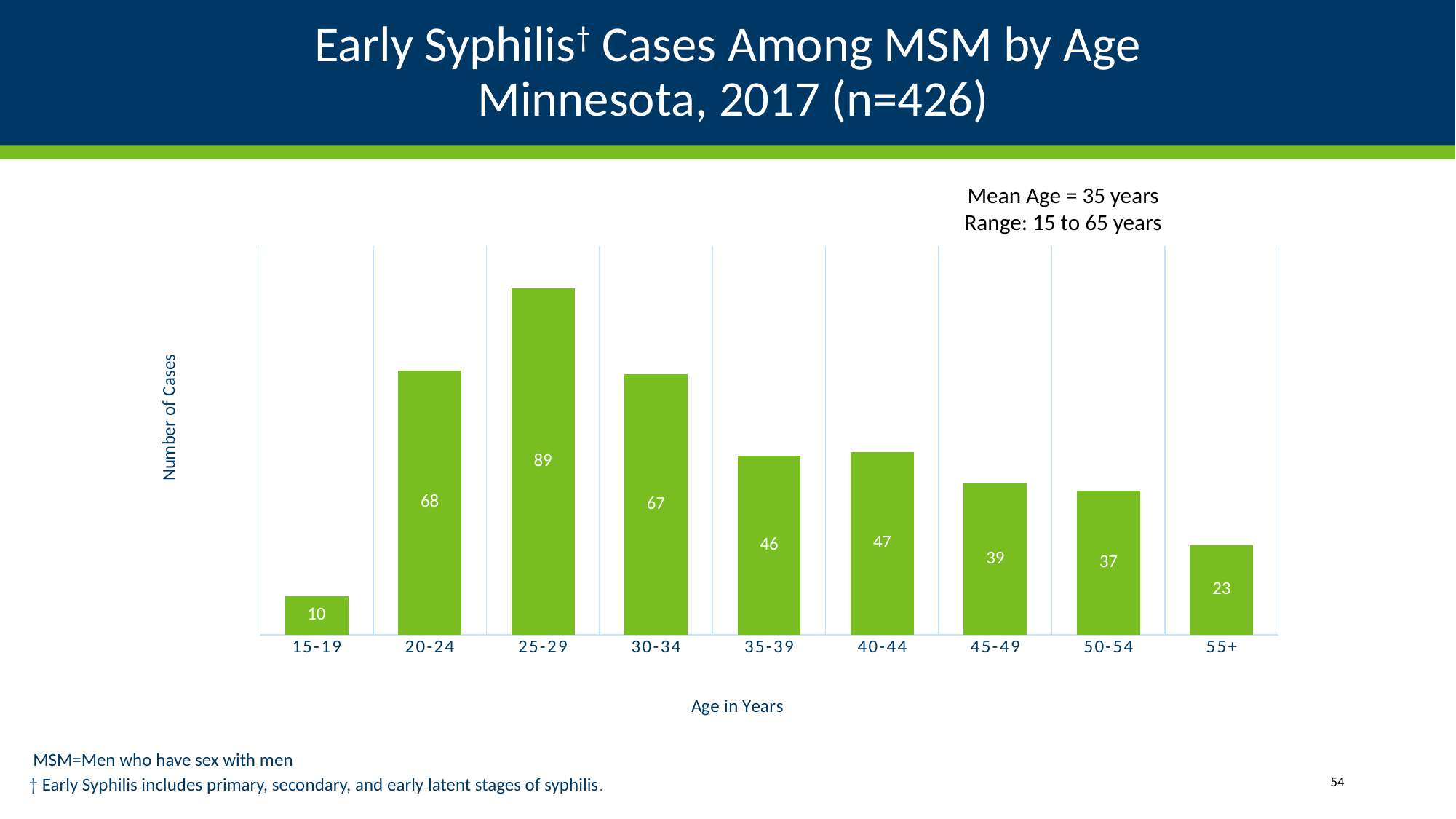
How many age groups are shown on the x axis? 9 How many early syphilis cases among MSM were in the 25-29 age group? 89 How many cases are shown for the 55+ age group? 23 Which age group has more cases, 45-49 or 50-54? 45-49 Which age group has the highest number of cases? 25-29 What is the difference in cases between the 25-29 and 30-34 age groups? 22 Which age group has more cases, 20-24 or 30-34? 20-24 What is the number of cases for the 15-19 age group? 10 What kind of chart is shown on the slide? Bar chart Which age group has the lowest number of cases? 15-19 Do the number of cases rise or fall from the 25-29 age group to the 55+ age group? Fall What is the label of the y axis? Number of Cases